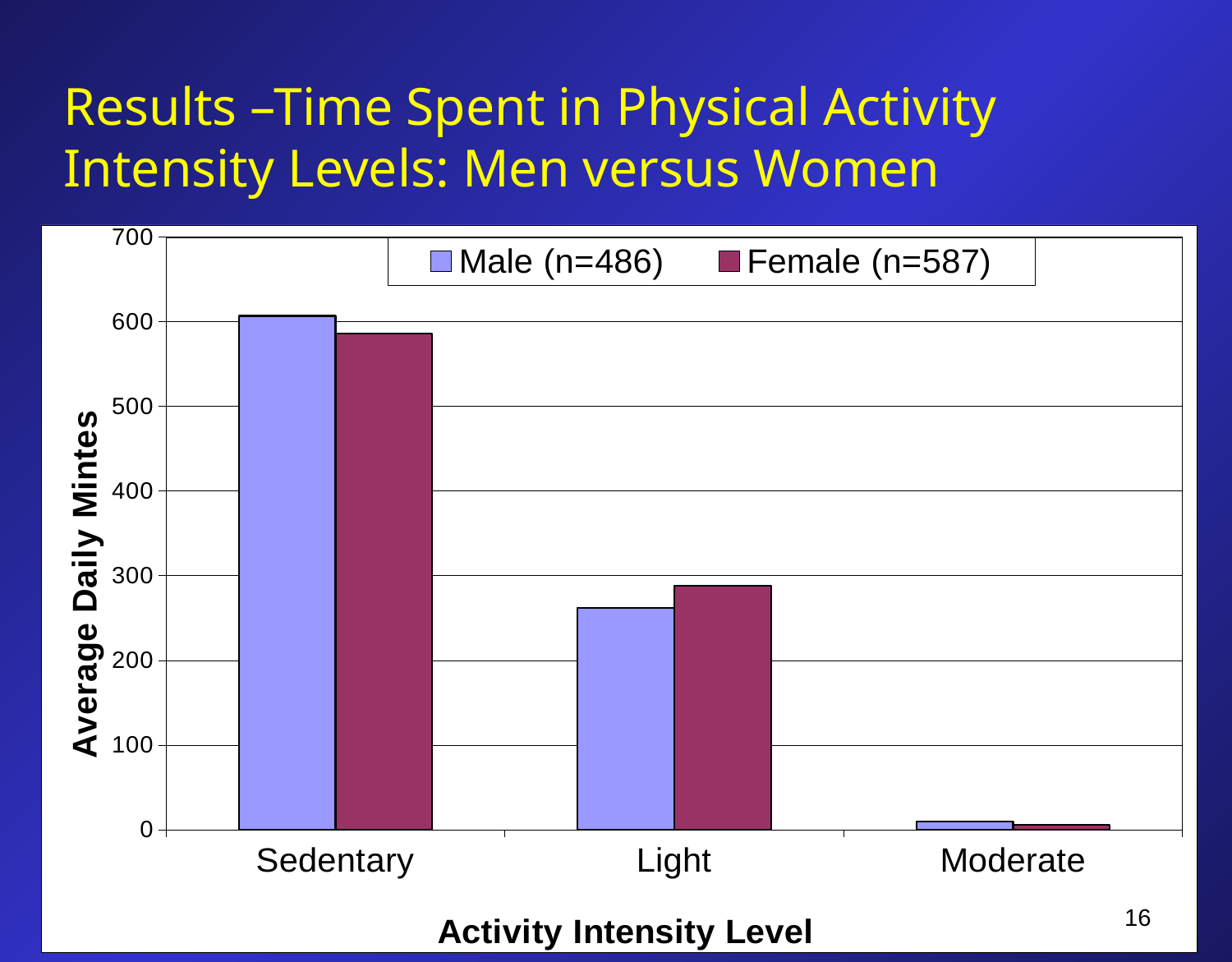
Is the Female (n=587) value for Light greater or less than 300? less Is the Male (n=486) value for Sedentary greater or less than 600? greater For the Sedentary category, which is larger: the Male (n=486) value or the Female (n=587) value? Male (n=486) Is the Male (n=486) value for Moderate greater or less than 100? less How many series does the legend list? 2 Which activity intensity level has the highest value for Male (n=486)? Sedentary Which activity intensity level has the lowest value for Female (n=587)? Moderate What is the label of the y axis? Average Daily Mintes For the Light category, which is larger: the Male (n=486) value or the Female (n=587) value? Female (n=587) What kind of chart is shown on the slide? bar chart How many activity intensity level categories are shown on the x axis? 3